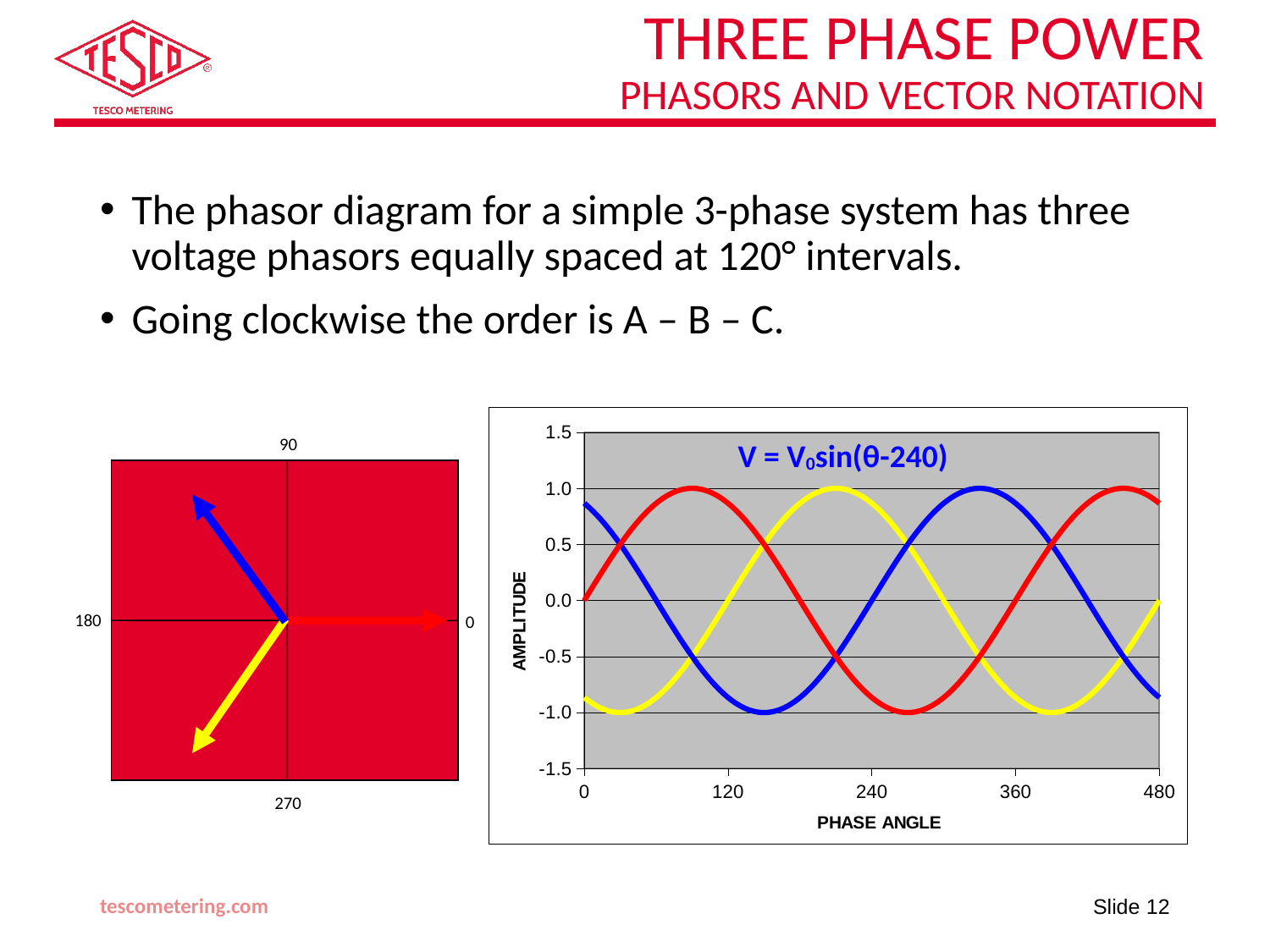
On the right-hand chart, what is the amplitude of the red line at a phase angle of 360? 0.0 On the right-hand chart, what is the title of the vertical axis? AMPLITUDE On the right-hand chart, how many lines (series) are plotted? 3 On the right-hand chart, is the amplitude of the yellow line at a phase angle of 0 greater or less than -0.5? less On the right-hand chart, what is the title of the horizontal axis? PHASE ANGLE On the right-hand chart, is the amplitude of the red line at a phase angle of 240 greater or less than -0.5? less On the right-hand chart, what is the amplitude of the red line at a phase angle of 0? 0.0 On the right-hand chart, what is the largest phase angle labelled on the horizontal axis? 480 On the right-hand chart, what is the highest value shown on the vertical axis? 1.5 On the right-hand chart, is the amplitude of the blue line at a phase angle of 0 greater or less than 0.5? greater On the left-hand phasor diagram, how many phasor arrows are drawn? 3 What kind of chart is the chart on the right of the slide? line chart